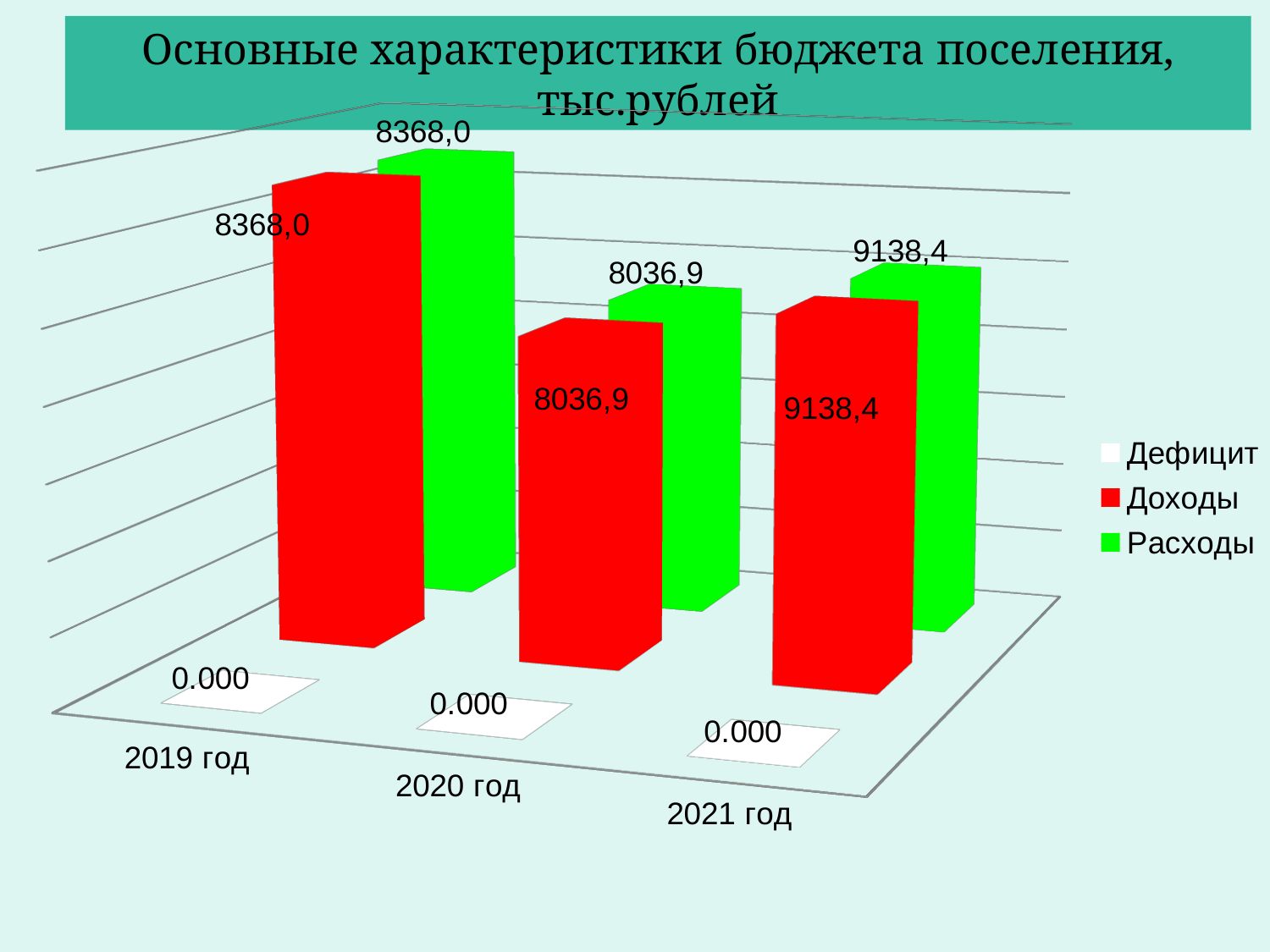
Which year has the lowest value for Расходы? 2020 год What is the value of Доходы for 2019 год? 8368,0 What kind of chart is shown on the slide? bar chart What is the value of Дефицит for 2020 год? 0.000 What is the value of Расходы for 2020 год? 8036,9 How many series does the legend list? 3 What is the difference between Доходы in 2021 год and Доходы in 2020 год? 1101,5 What colour represents Расходы in the legend? green Which is larger: Расходы in 2019 год or Расходы in 2020 год? 2019 год What is the value of Расходы for 2021 год? 9138,4 How many years are shown on the x axis? 3